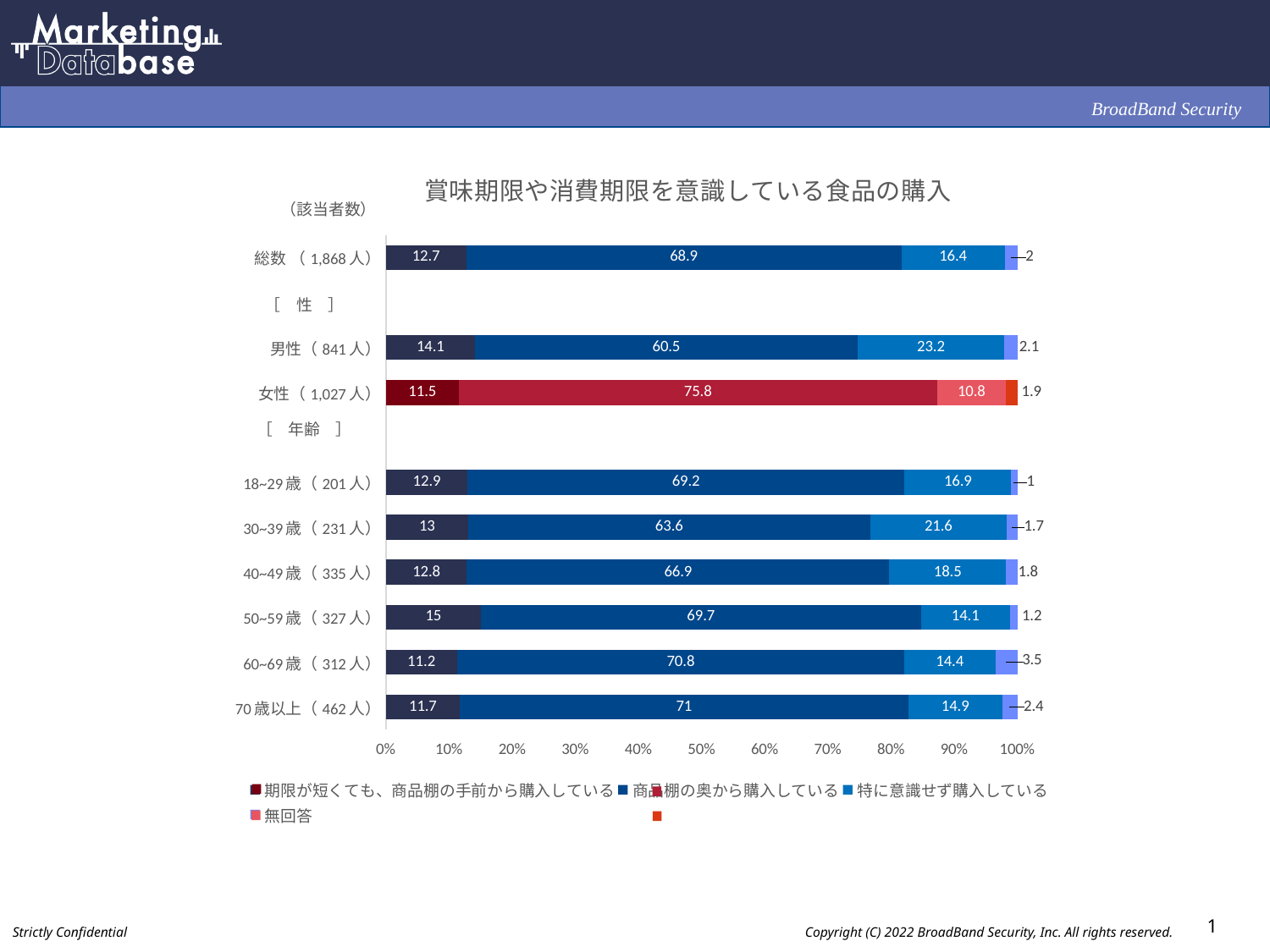
Which category has the lowest value for 商品棚の奥から購入している? 男性 (841人) Which category has the highest value for 期限が短くても、商品棚の手前から購入している? 50~59歳 (327人) What is the value of 商品棚の奥から購入している for 総数 (1,868人)? 68.9 What kind of chart is shown on the slide? Stacked bar chart How many series does the legend list? 4 What is the value of 特に意識せず購入している for 男性 (841人)? 23.2 How many category bars are plotted in the chart? 9 What is the value of 期限が短くても、商品棚の手前から購入している for 女性 (1,027人)? 11.5 Which is larger for 特に意識せず購入している: 30~39歳 or 50~59歳? 30~39歳 What is the difference between 女性 and 男性 for 商品棚の奥から購入している? 15.3 Which category has the highest value for 商品棚の奥から購入している? 女性 (1,027人) What is the value of 無回答 for 60~69歳 (312人)? 3.5